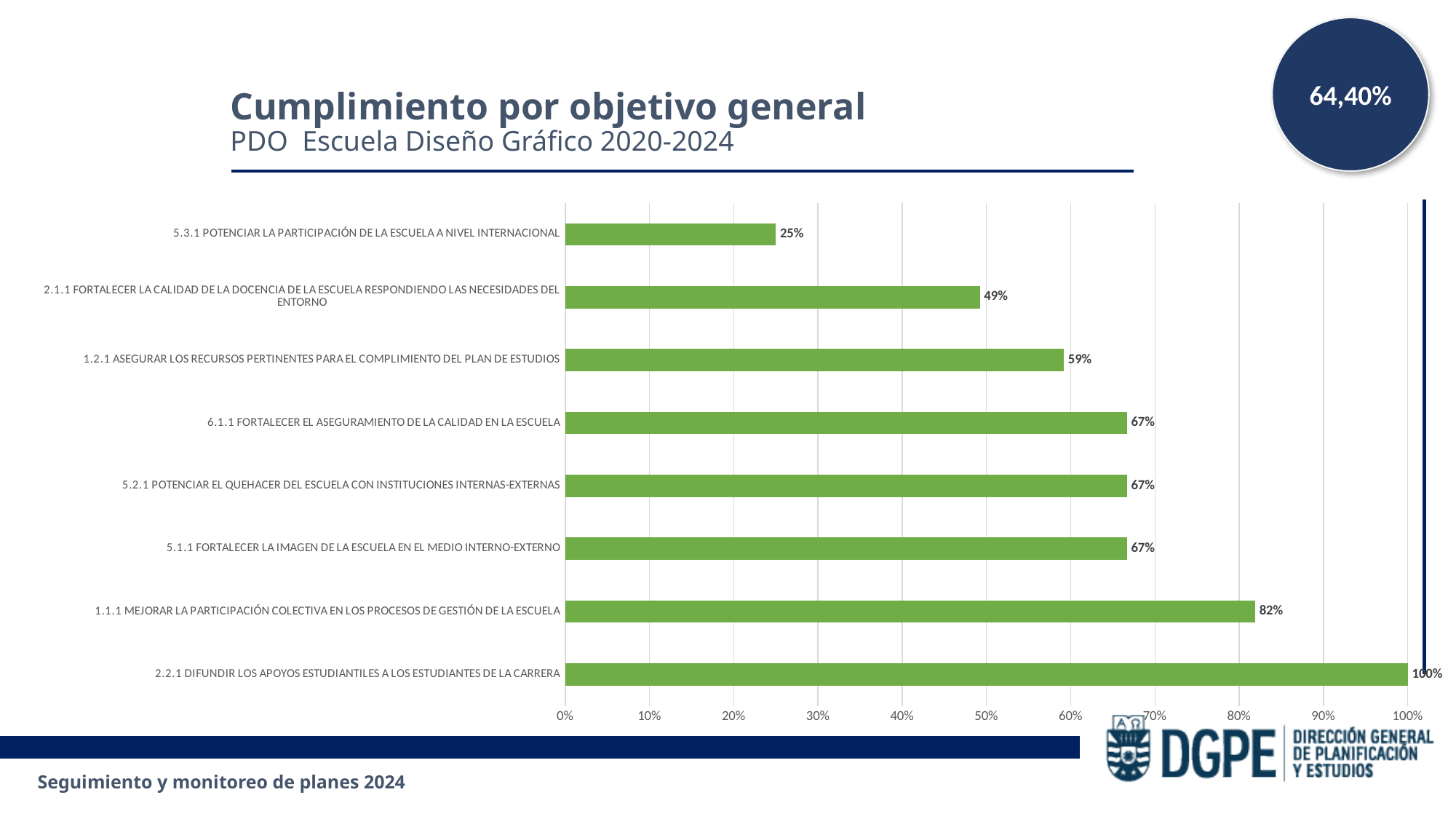
What is the value for 1.2.1 ASEGURAR LOS RECURSOS PERTINENTES PARA EL COMPLIMIENTO DEL PLAN DE ESTUDIOS? 59% What is the difference between the value for 1.2.1 ASEGURAR LOS RECURSOS PERTINENTES PARA EL COMPLIMIENTO DEL PLAN DE ESTUDIOS and the value for 5.3.1 POTENCIAR LA PARTICIPACIÓN DE LA ESCUELA A NIVEL INTERNACIONAL? 34% What is the title of the chart on the slide? Cumplimiento por objetivo general How many objectives are shown in the chart? 8 Which objective has the highest value? 2.2.1 DIFUNDIR LOS APOYOS ESTUDIANTILES A LOS ESTUDIANTES DE LA CARRERA Which is larger: the value for 2.1.1 FORTALECER LA CALIDAD DE LA DOCENCIA DE LA ESCUELA RESPONDIENDO LAS NECESIDADES DEL ENTORNO or the value for 6.1.1 FORTALECER EL ASEGURAMIENTO DE LA CALIDAD EN LA ESCUELA? 6.1.1 FORTALECER EL ASEGURAMIENTO DE LA CALIDAD EN LA ESCUELA Which objective has the lowest value? 5.3.1 POTENCIAR LA PARTICIPACIÓN DE LA ESCUELA A NIVEL INTERNACIONAL Is the value for 2.1.1 FORTALECER LA CALIDAD DE LA DOCENCIA DE LA ESCUELA RESPONDIENDO LAS NECESIDADES DEL ENTORNO greater or less than 50%? less What is the value for 1.1.1 MEJORAR LA PARTICIPACIÓN COLECTIVA EN LOS PROCESOS DE GESTIÓN DE LA ESCUELA? 82% What kind of chart is shown on the slide? bar chart What is the difference between the value for 2.2.1 DIFUNDIR LOS APOYOS ESTUDIANTILES A LOS ESTUDIANTES DE LA CARRERA and the value for 1.1.1 MEJORAR LA PARTICIPACIÓN COLECTIVA EN LOS PROCESOS DE GESTIÓN DE LA ESCUELA? 18% What is the value for 5.3.1 POTENCIAR LA PARTICIPACIÓN DE LA ESCUELA A NIVEL INTERNACIONAL? 25%